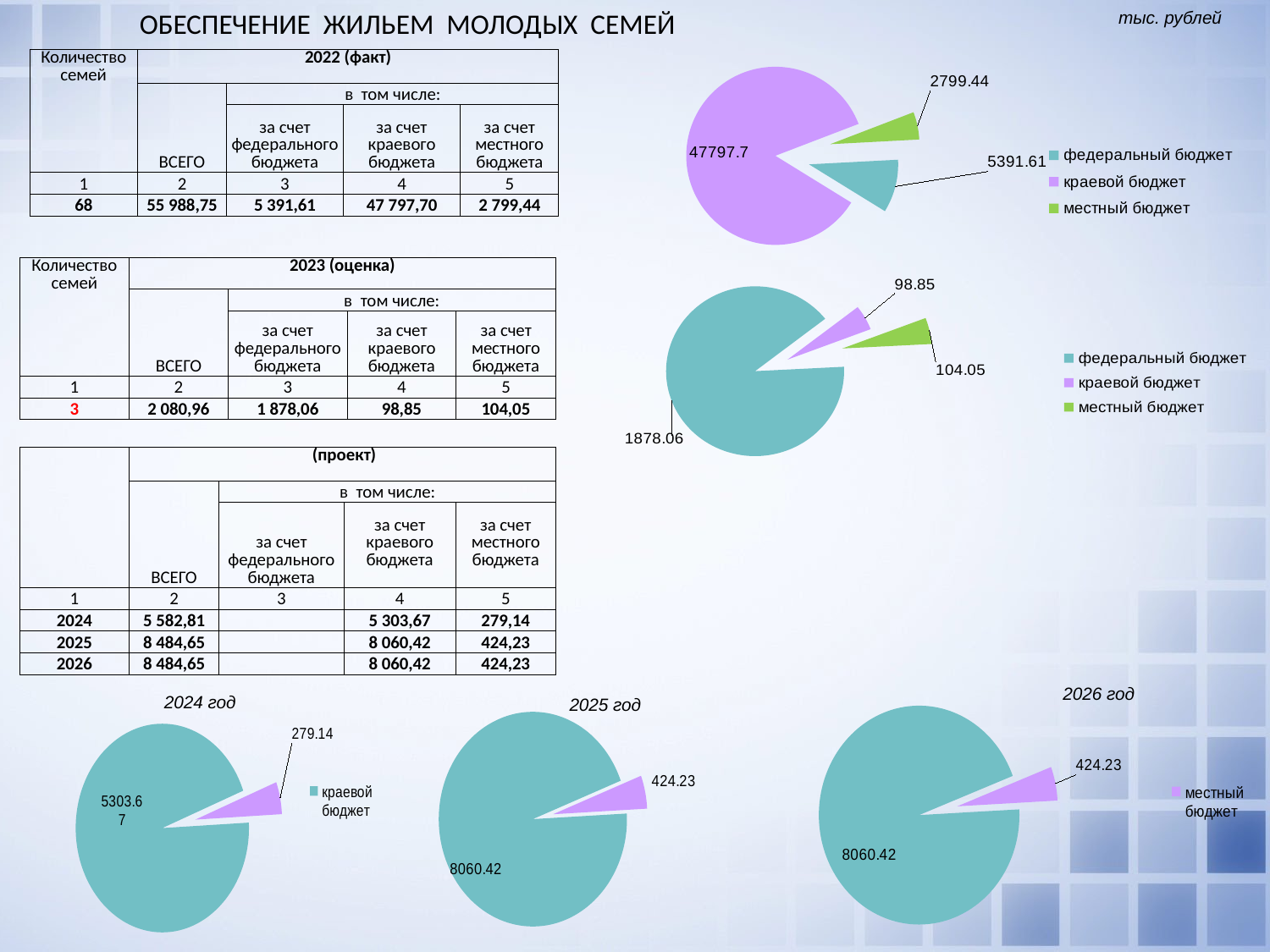
In the pie chart titled 2024 год, what share of the total does the 279.14 slice represent? 5% In the top pie chart on the right, how many slices does the pie have? 3 In the middle pie chart on the right, what is the total of all three slice values? 2080.96 How many entries does the legend of the top pie chart on the right list? 3 In the top pie chart on the right, what is the value of the местный бюджет slice? 2799.44 In the middle pie chart on the right, which is larger: the краевой бюджет slice or the местный бюджет slice? местный бюджет In the top pie chart on the right, what is the difference between the федеральный бюджет value and the местный бюджет value? 2592.17 In the top pie chart on the right, what is the value of the краевой бюджет slice? 47797.7 In the top pie chart on the right, which budget has the largest slice? краевой бюджет What type of chart is the middle chart on the right side of the slide? pie chart In the pie chart titled 2024 год, what is the value of the small slice? 279.14 In the middle pie chart on the right, what is the value of the федеральный бюджет slice? 1878.06